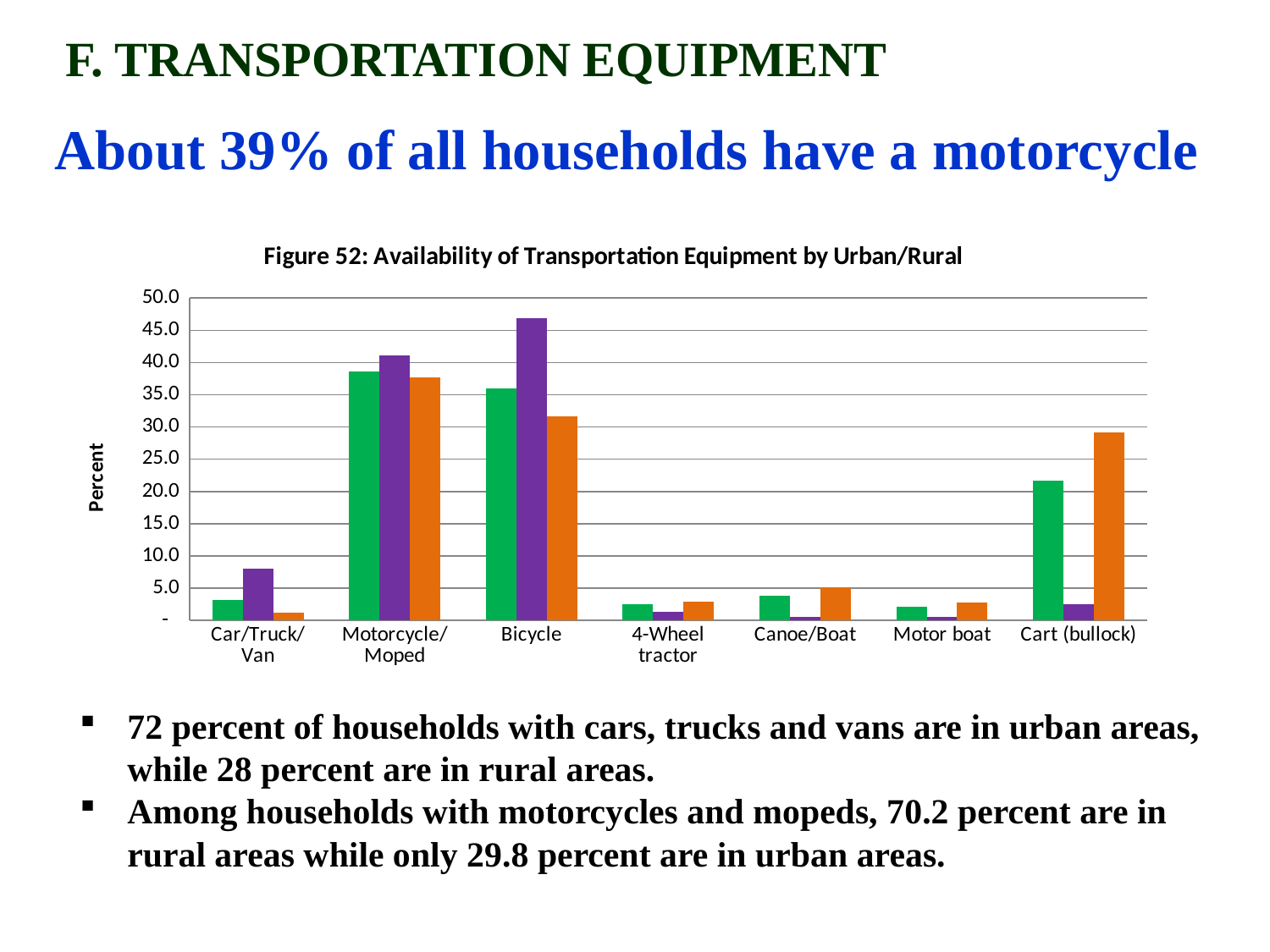
For Cart (bullock), which is larger: the green bar or the orange bar? the orange bar What is the label on the vertical axis of the chart? Percent What is the title of the chart? Figure 52: Availability of Transportation Equipment by Urban/Rural Is the value of the purple bar for Car/Truck/Van greater or less than 5.0? greater Which category contains the tallest bar in the chart? Bicycle What kind of chart is shown on the slide? bar chart How many transportation equipment categories are shown on the x axis of the chart? 7 Is the value of the purple bar for Bicycle greater or less than 45.0? greater Which purple bar is taller: Motorcycle/Moped or Bicycle? Bicycle Is the value of the green bar for Car/Truck/Van greater or less than 5.0? less